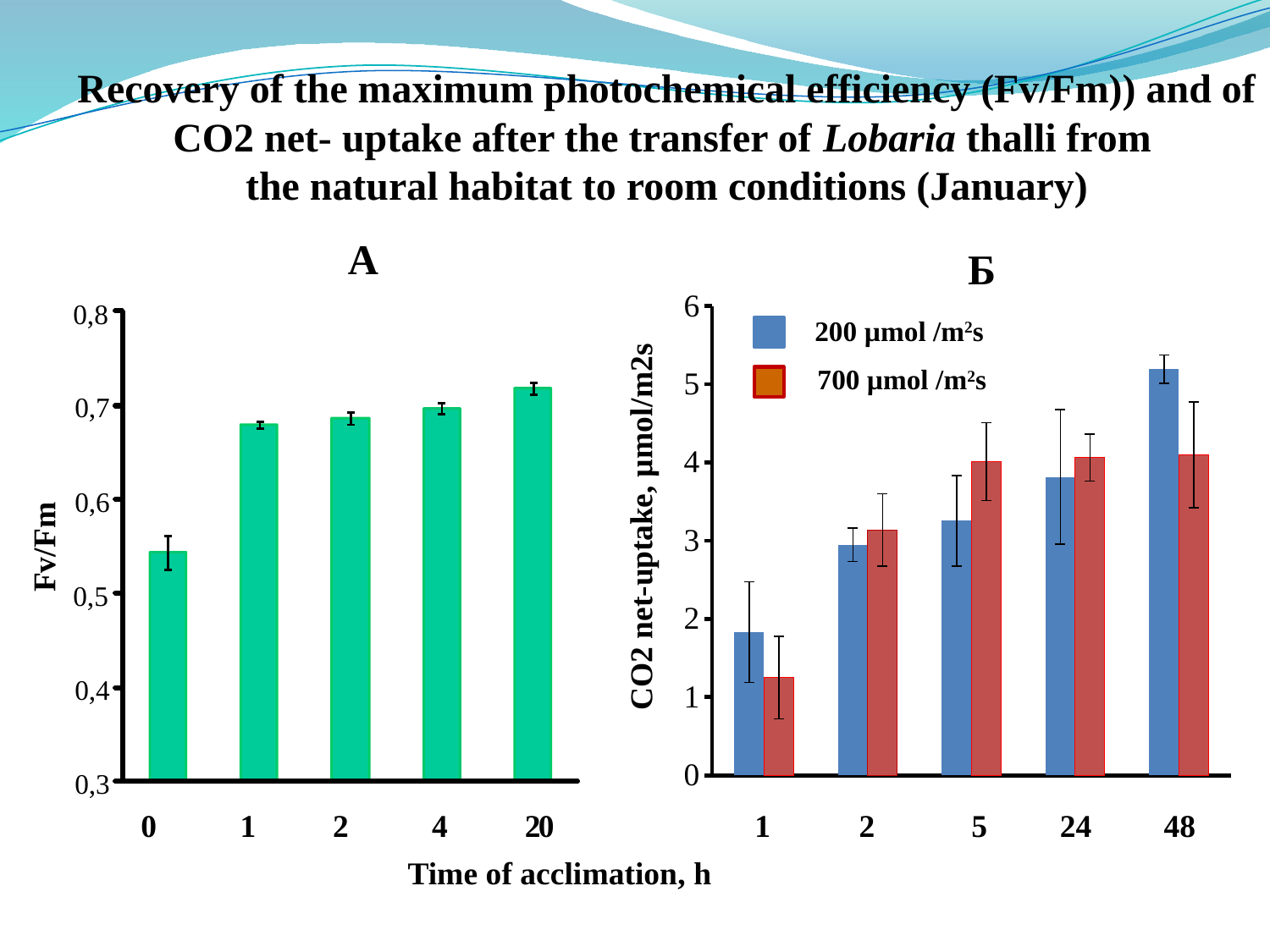
In chart A, is the Fv/Fm value at time 0 greater or less than 0,6? less In chart Б, how many series does the legend list? 2 What kind of chart is chart A? bar chart In chart A, at which time of acclimation is Fv/Fm highest? 20 In chart Б, at 48 h, which series has the larger CO2 net-uptake, 200 µmol /m²s or 700 µmol /m²s? 200 µmol /m²s In chart A, do the Fv/Fm values rise or fall as time of acclimation increases? rise In chart Б, is the CO2 net-uptake for 200 µmol /m²s at 48 h greater or less than 5? greater In chart A, how many time points are shown on the x axis? 5 In chart Б, at which time of acclimation is CO2 net-uptake for 200 µmol /m²s highest? 48 In chart A, is the Fv/Fm value at time 20 greater or less than 0,7? greater In chart Б, what is the label of the y axis? CO2 net-uptake, µmol/m2s In chart A, at which time of acclimation is Fv/Fm lowest? 0